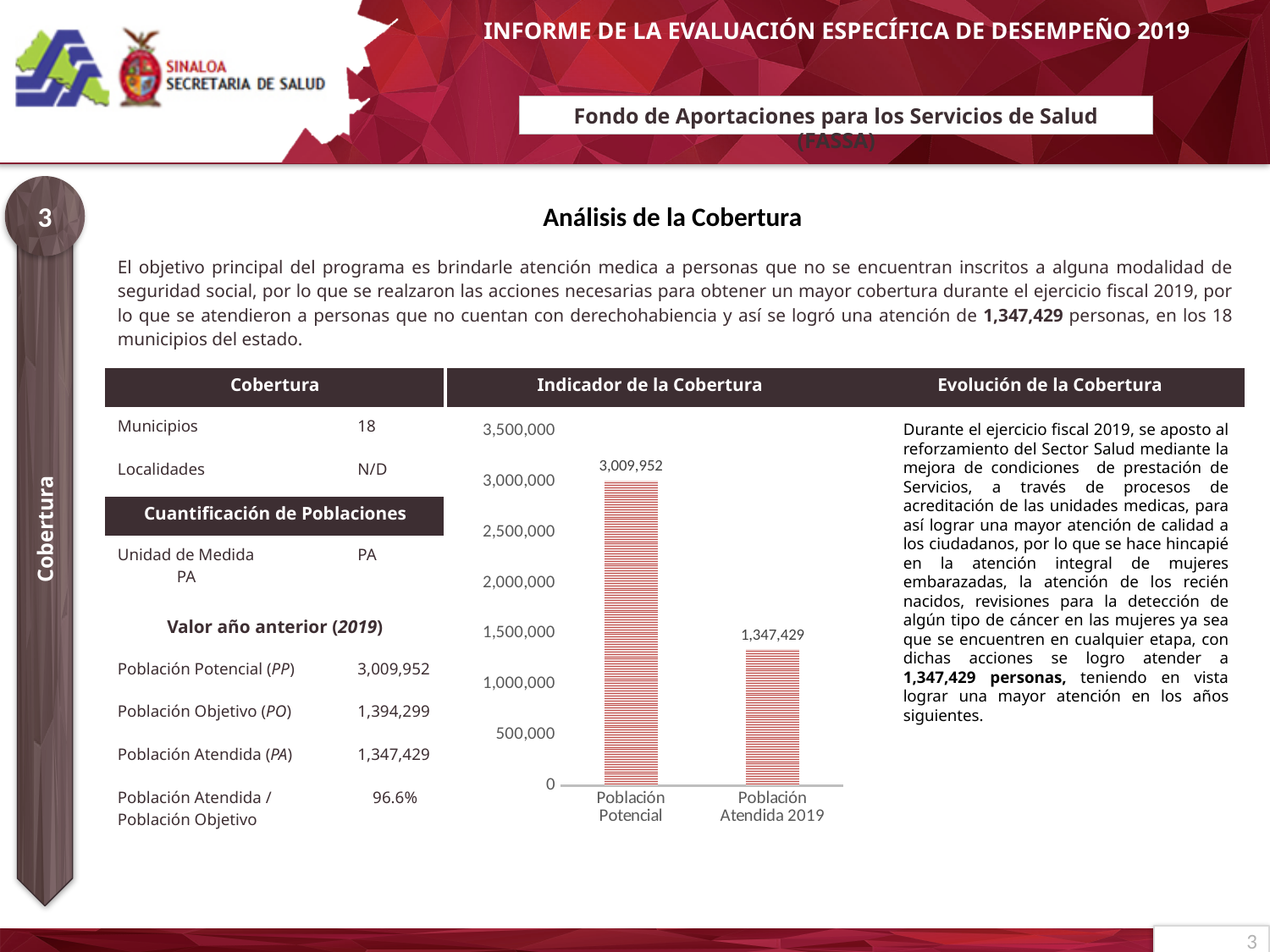
Which category has the lowest value in the chart? Población Atendida 2019 Which category has the highest value in the chart? Población Potencial What is the value for Población Atendida 2019 in the chart? 1,347,429 What kind of chart is shown on the slide? bar chart What is the value for Población Potencial in the chart? 3,009,952 What is the difference between the values for Población Potencial and Población Atendida 2019? 1,662,523 Is the value for Población Potencial greater or less than 3,000,000? greater What is the heading above the chart? Indicador de la Cobertura Is the value for Población Atendida 2019 greater or less than 1,500,000? less Which is larger, the value for Población Potencial or the value for Población Atendida 2019? Población Potencial What is the highest value shown on the chart's vertical axis? 3,500,000 How many categories are shown in the chart? 2